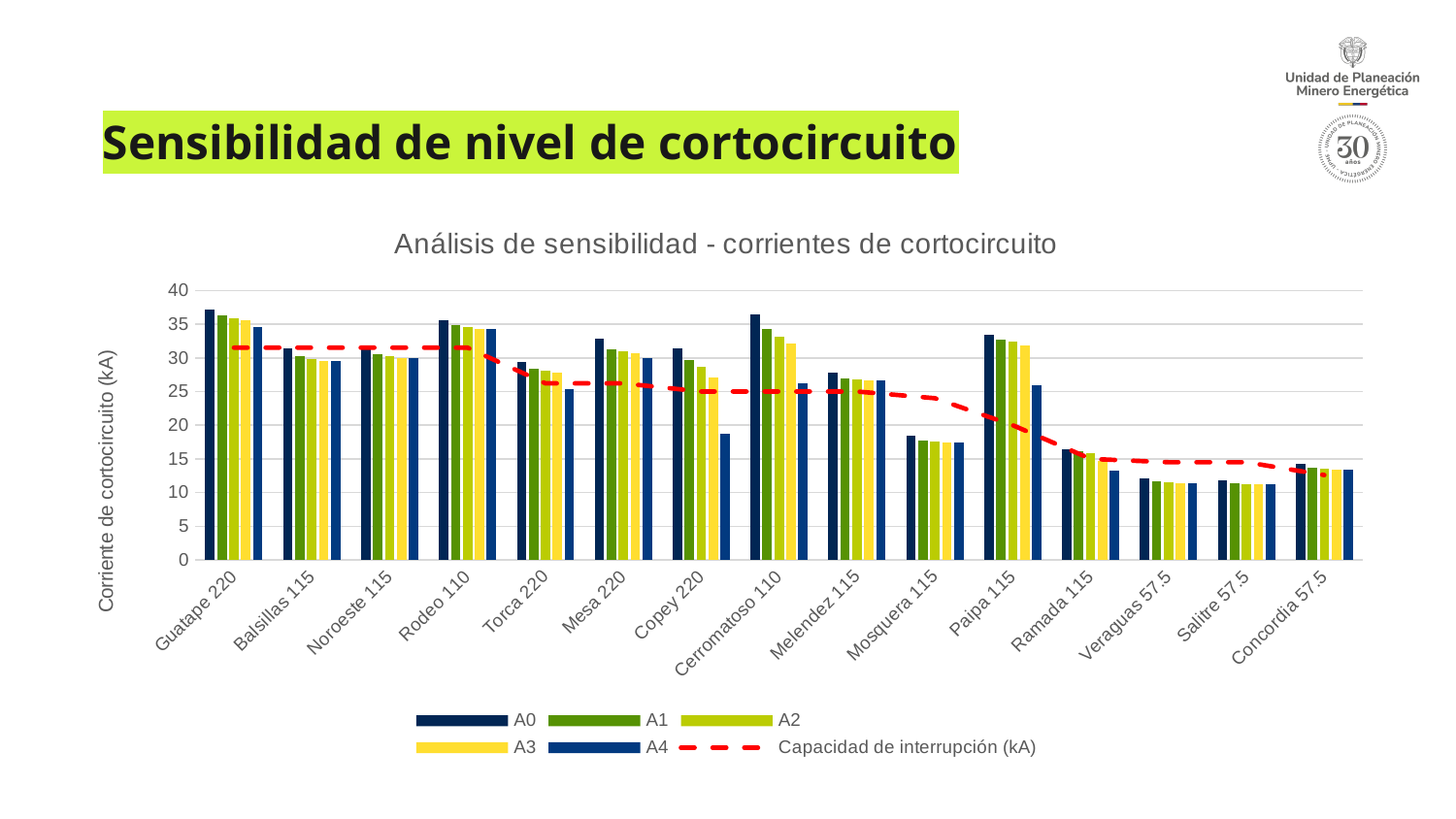
What kind of chart is shown on the slide? Bar chart (with a dashed line series) Do the short-circuit current values generally rise or fall from left to right along the x axis? fall How many series does the legend list? 6 How many categories (substations) are shown on the x axis? 15 For Copey 220, which is larger, the A0 value or the A4 value? A0 Is the A4 value for Copey 220 greater or less than 20? less Is the A0 value for Mosquera 115 greater or less than 20? less Is the A0 value for Paipa 115 greater or less than 30? greater Which is larger, the A0 value for Guatape 220 or the A0 value for Mosquera 115? Guatape 220 What is the title of the chart? Análisis de sensibilidad - corrientes de cortocircuito Which series is drawn as a red dashed line? Capacidad de interrupción (kA)